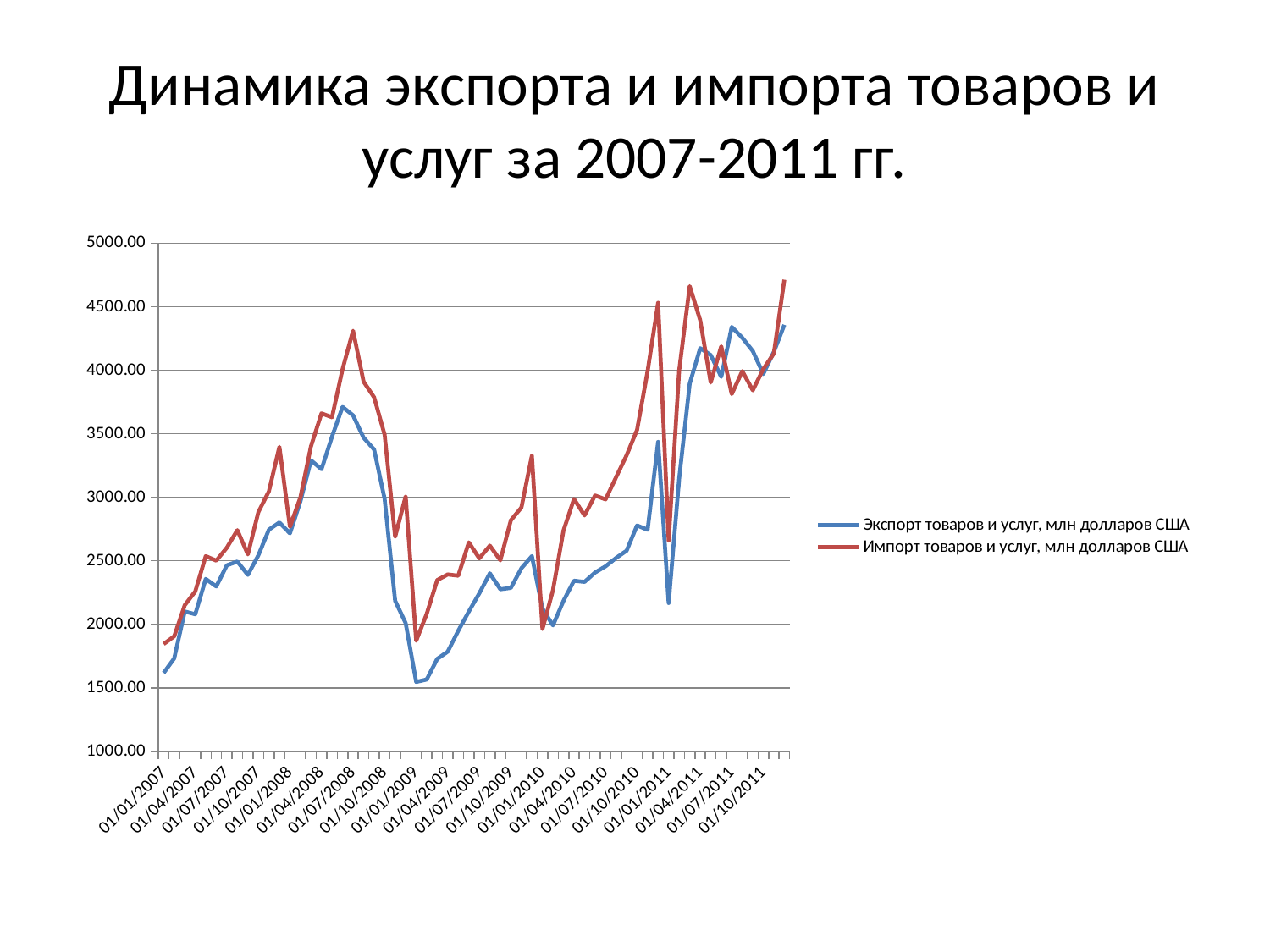
What kind of chart is shown on the slide? line chart Is the value for Экспорт товаров и услуг at 01/01/2009 greater or less than 2000.00? less How many series does the legend list? 2 How many date labels are shown on the x axis? 20 Which series is drawn in red? Импорт товаров и услуг, млн долларов США Does the Экспорт line rise or fall between 01/07/2008 and 01/01/2009? fall Is the value for Экспорт товаров и услуг at 01/07/2008 greater or less than 3500.00? greater Which series reaches the highest value anywhere on the chart? Импорт товаров и услуг, млн долларов США At 01/07/2008, which series has the larger value, Экспорт or Импорт? Импорт Is the value for Импорт товаров и услуг at 01/07/2008 greater or less than 4000.00? greater What is the title of the slide's chart? Динамика экспорта и импорта товаров и услуг за 2007-2011 гг.